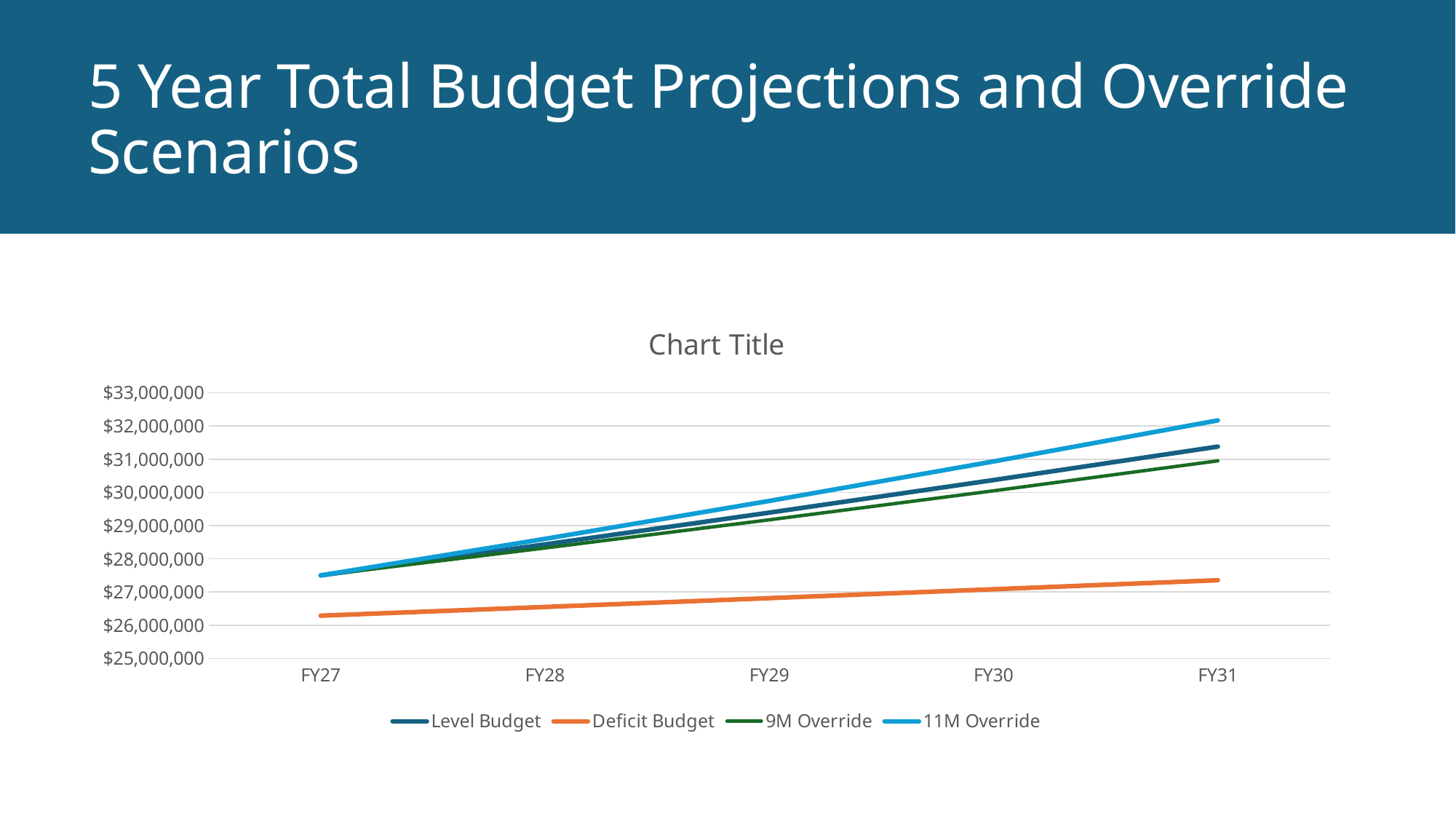
Does the Deficit Budget line rise or fall from FY27 to FY31? rise How many series does the legend list? 4 Is the value for Level Budget at FY29 greater or less than $29,000,000? greater Which series has the lowest value at FY31? Deficit Budget At FY27, which is larger: Level Budget or Deficit Budget? Level Budget What kind of chart is shown on the slide? line chart What is the title printed above the chart? Chart Title At FY31, which is larger: 11M Override or Level Budget? 11M Override Is the value for Deficit Budget at FY27 greater or less than $27,000,000? less Which series has the highest value at FY31? 11M Override How many fiscal years are shown on the x axis? 5 Is the value for 11M Override at FY31 greater or less than $32,000,000? greater